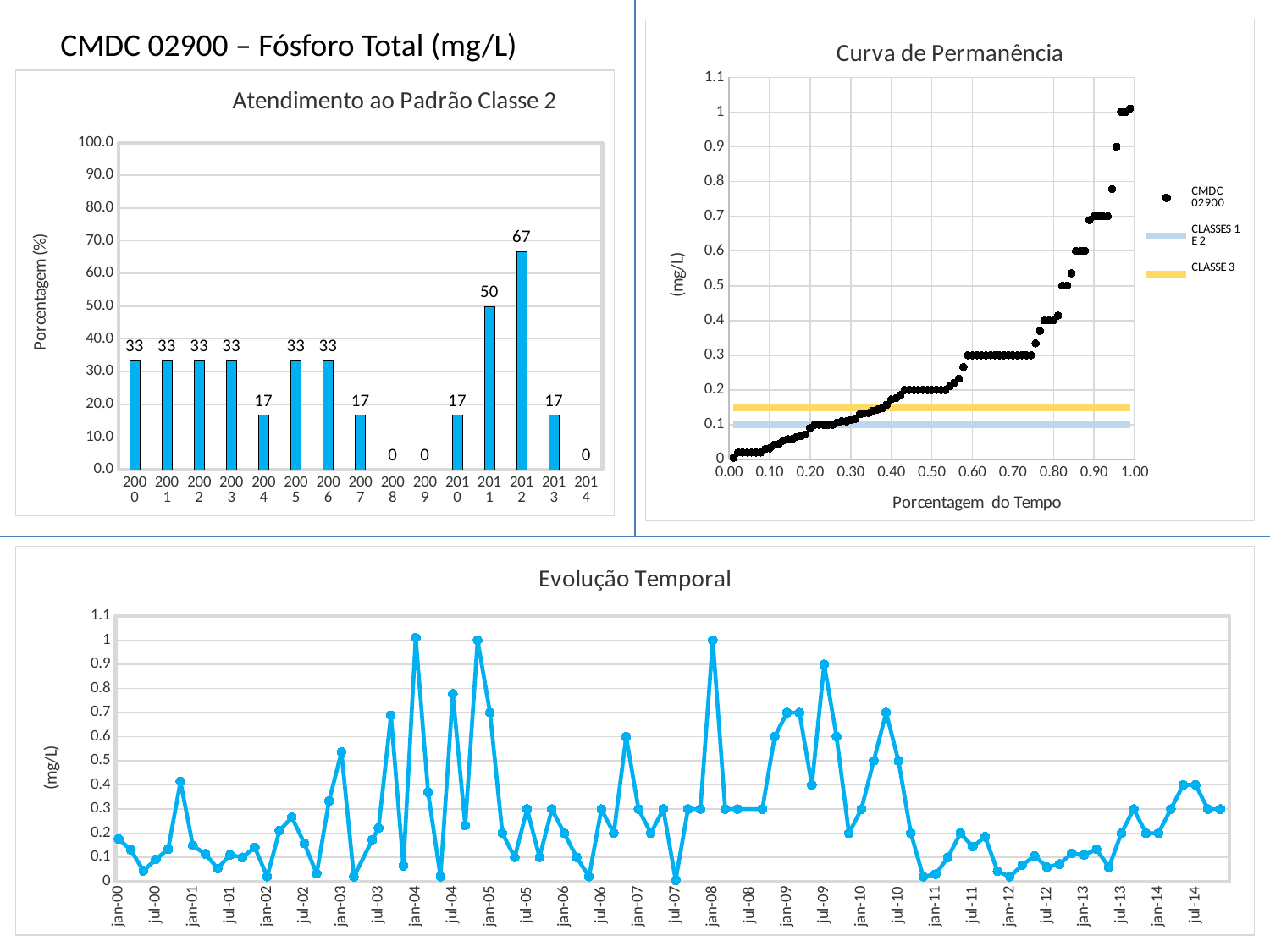
In the 'Atendimento ao Padrão Classe 2' chart, which is larger, the value for 2005 or the value for 2007? 2005 In the 'Atendimento ao Padrão Classe 2' chart, which year has the highest value? 2012 In the 'Atendimento ao Padrão Classe 2' chart, what is the value for 2012? 67 What kind of chart is 'Atendimento ao Padrão Classe 2'? bar chart What is the y-axis label of the 'Evolução Temporal' chart? (mg/L) In the 'Atendimento ao Padrão Classe 2' chart, what is the difference between the values for 2012 and 2011? 17 In the 'Atendimento ao Padrão Classe 2' chart, what is the value for 2011? 50 In the 'Atendimento ao Padrão Classe 2' chart, how many years are shown on the x axis? 15 In the 'Atendimento ao Padrão Classe 2' chart, what is the value for 2004? 17 In the 'Evolução Temporal' chart, is the value at jan-04 greater or less than 0.9? greater How many series does the legend of the 'Curva de Permanência' chart list? 3 In the 'Curva de Permanência' chart, do the CMDC 02900 values rise or fall as the percentage of time increases? rise